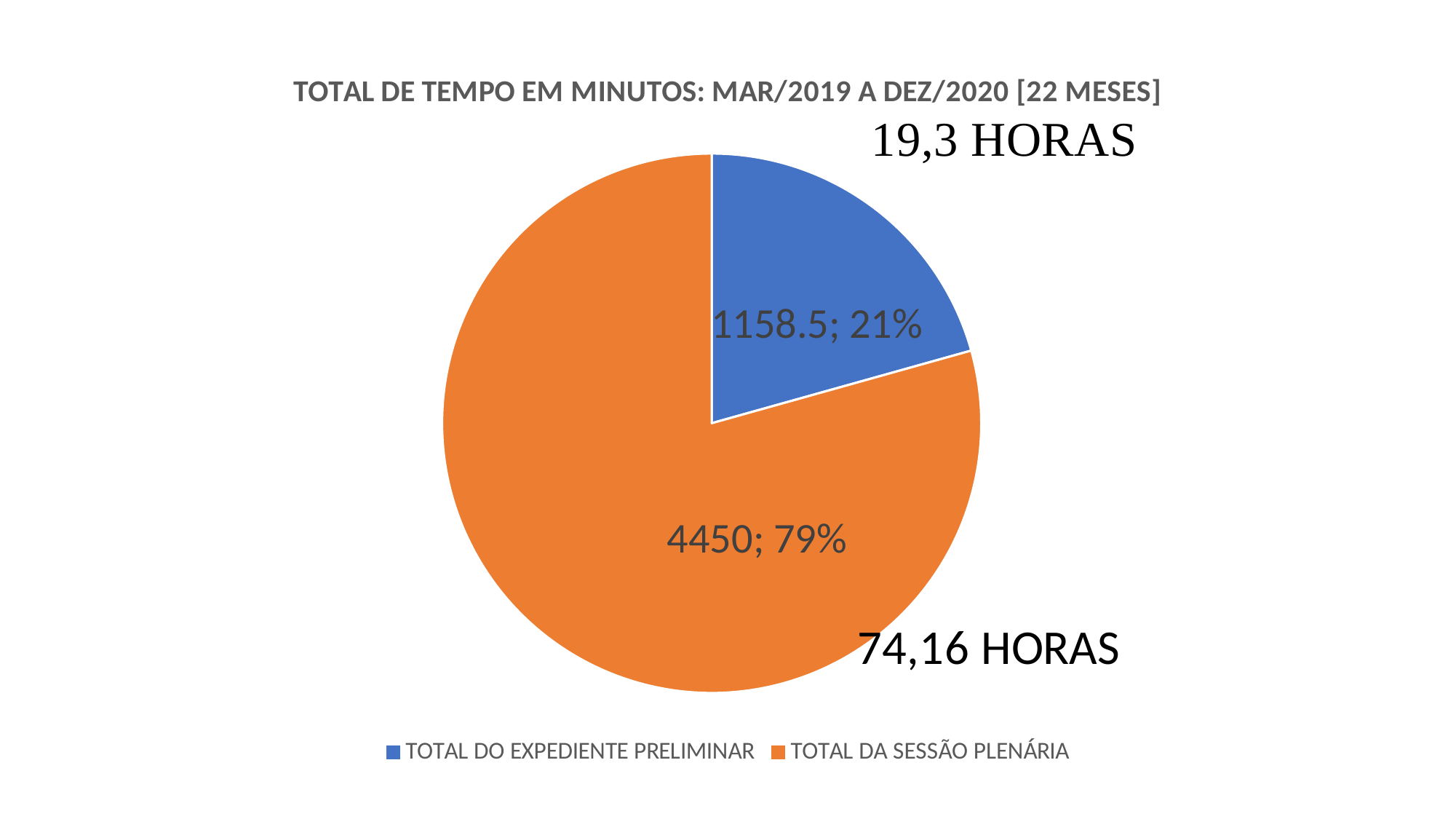
What is the value in minutes for TOTAL DA SESSÃO PLENÁRIA? 4450 What is the value in minutes for TOTAL DO EXPEDIENTE PRELIMINAR? 1158.5 What is the title of the chart? TOTAL DE TEMPO EM MINUTOS: MAR/2019 A DEZ/2020 [22 MESES] What colour is the slice for TOTAL DA SESSÃO PLENÁRIA? orange What type of chart is shown on the slide? pie chart What share of the pie does TOTAL DO EXPEDIENTE PRELIMINAR represent? 21% What is the difference in minutes between TOTAL DA SESSÃO PLENÁRIA and TOTAL DO EXPEDIENTE PRELIMINAR? 3291.5 How many slices does the pie chart have? 2 Which category has the largest slice of the pie? TOTAL DA SESSÃO PLENÁRIA Which is larger, TOTAL DO EXPEDIENTE PRELIMINAR or TOTAL DA SESSÃO PLENÁRIA? TOTAL DA SESSÃO PLENÁRIA What share of the pie does TOTAL DA SESSÃO PLENÁRIA represent? 79% Which category has the smallest slice of the pie? TOTAL DO EXPEDIENTE PRELIMINAR